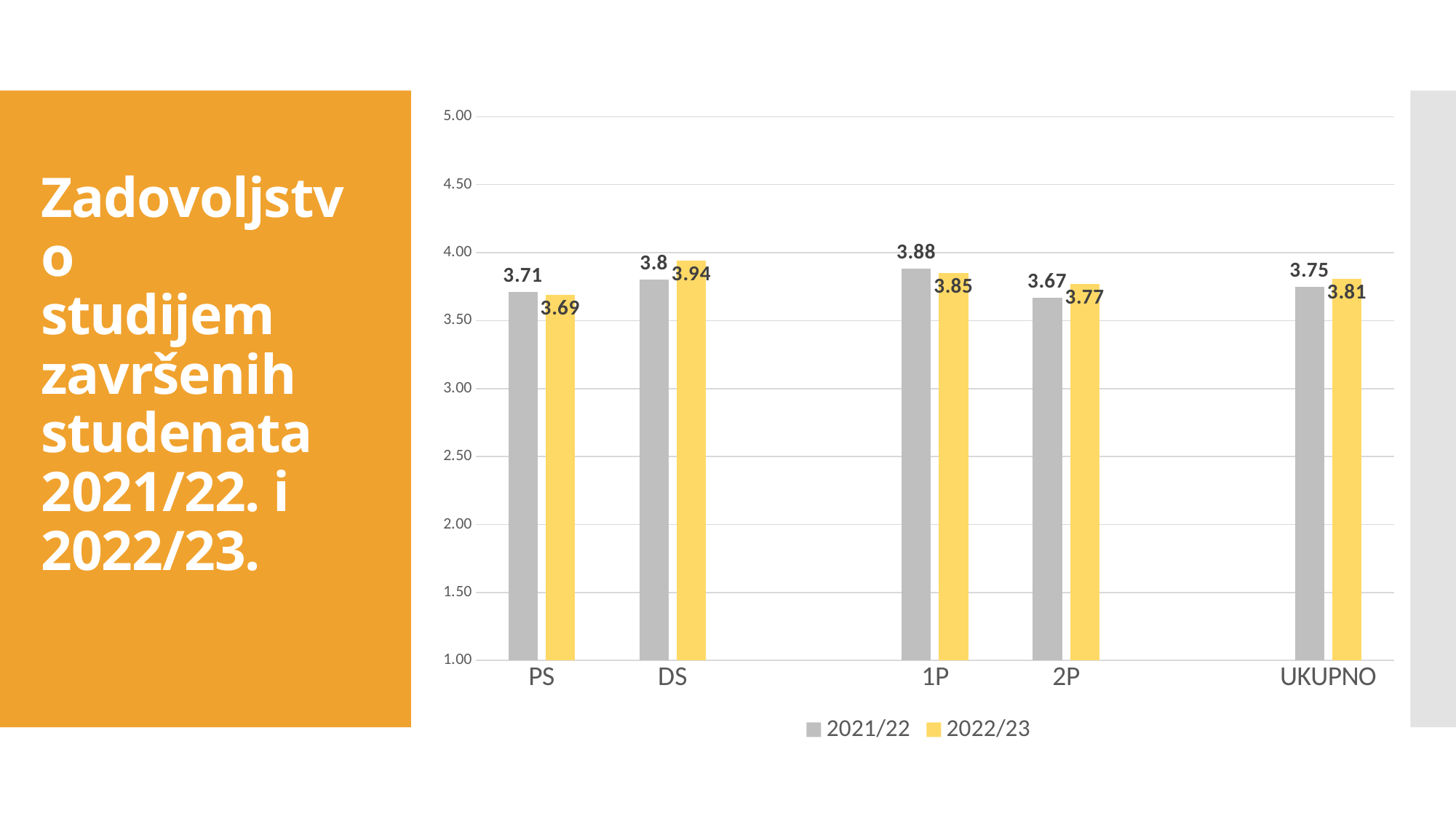
Which is larger for 2P: the 2021/22 value or the 2022/23 value? 2022/23 Is the value for 1P in the 2022/23 series greater or less than 4.00? less What is the difference between the 2021/22 and 2022/23 values for PS? 0.02 What is the value for 1P in the 2021/22 series? 3.88 What is the value for DS in the 2022/23 series? 3.94 Which category has the lowest value in the 2021/22 series? 2P What is the difference between the 2022/23 and 2021/22 values for DS? 0.14 Which category has the highest value in the 2022/23 series? DS What is the value for UKUPNO in the 2022/23 series? 3.81 How many categories are shown on the x axis? 5 What kind of chart is shown on the slide? bar chart How many series does the legend list? 2